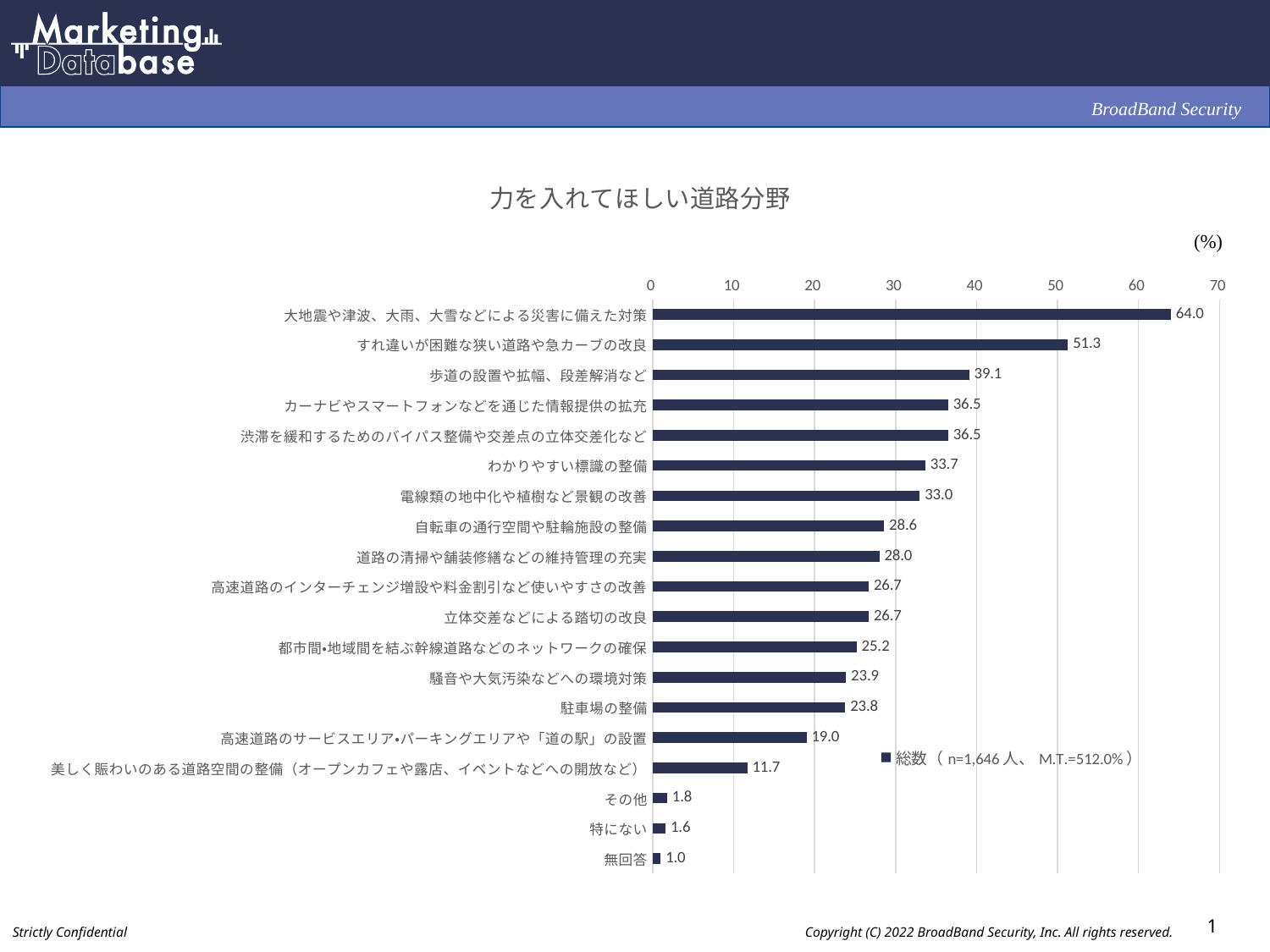
What type of chart is shown on the slide? Bar chart What is the value for 駐車場の整備? 23.8 Which is larger, the value for わかりやすい標識の整備 or the value for 電線類の地中化や植樹など景観の改善? わかりやすい標識の整備 What is the value for 歩道の設置や拡幅、段差解消など? 39.1 What is the title of the chart? 力を入れてほしい道路分野 What is the difference between the values for すれ違いが困難な狭い道路や急カーブの改良 and 歩道の設置や拡幅、段差解消など? 12.2 How many series does the legend list? 1 How many categories are shown in the chart? 19 What is the sample size (n) shown in the legend? 1,646 Which category has the lowest value? 無回答 Which category has the highest value? 大地震や津波、大雨、大雪などによる災害に備えた対策 What is the value for 大地震や津波、大雨、大雪などによる災害に備えた対策? 64.0